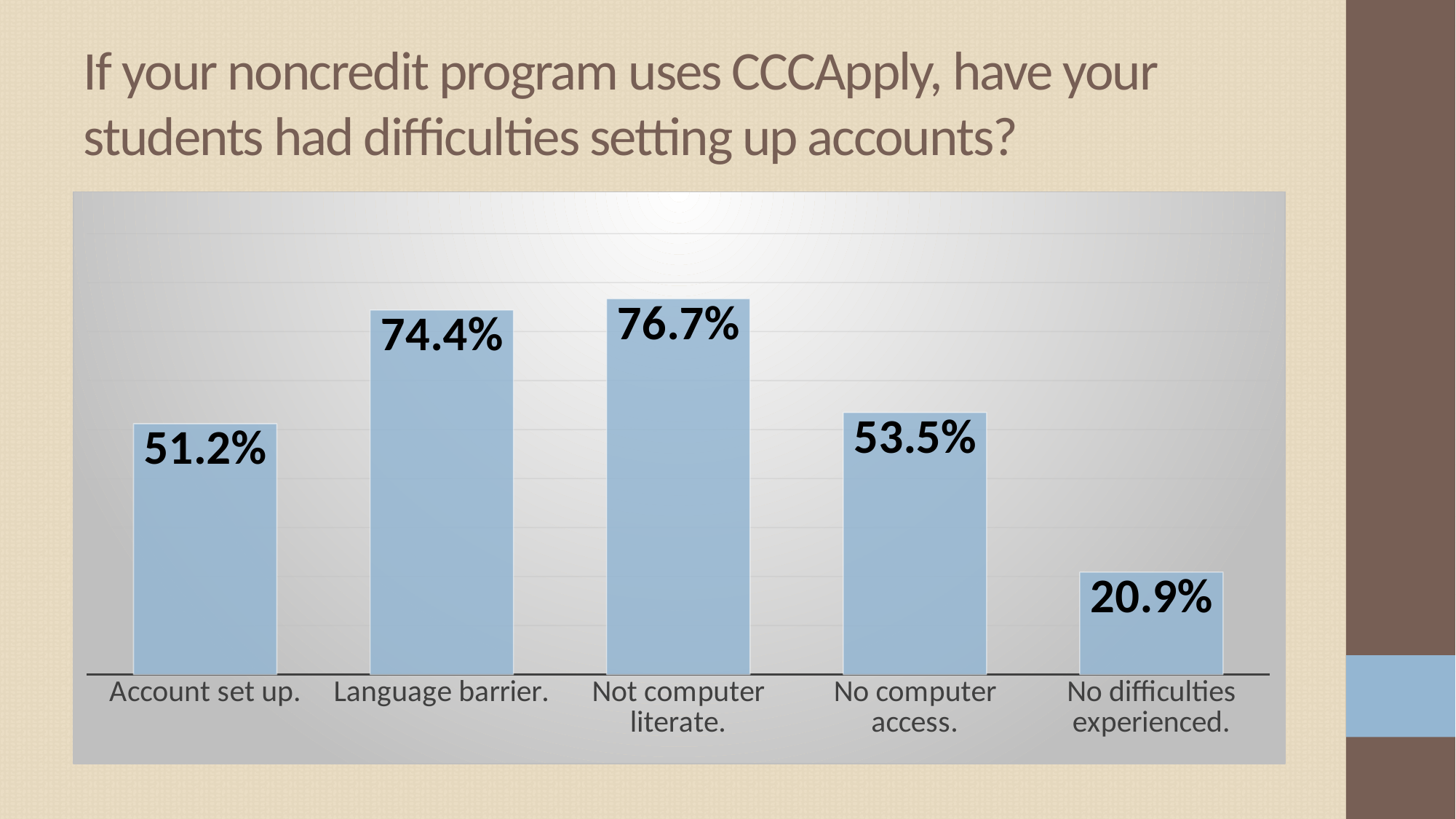
Which category has the highest value? Not computer literate. Which category has the lowest value? No difficulties experienced. What is the value for Account set up? 51.2% What is the value for No difficulties experienced? 20.9% What kind of chart is shown on the slide? Bar chart What is the value for Language barrier? 74.4% What is the difference between the values for No computer access and No difficulties experienced? 32.6% Which is larger, the value for Account set up or the value for No computer access? No computer access What is the difference between the values for Not computer literate and Language barrier? 2.3% How many categories are shown in the chart? 5 What colour are the bars in the chart? Light blue What is the title of the slide containing the chart? If your noncredit program uses CCCApply, have your students had difficulties setting up accounts?